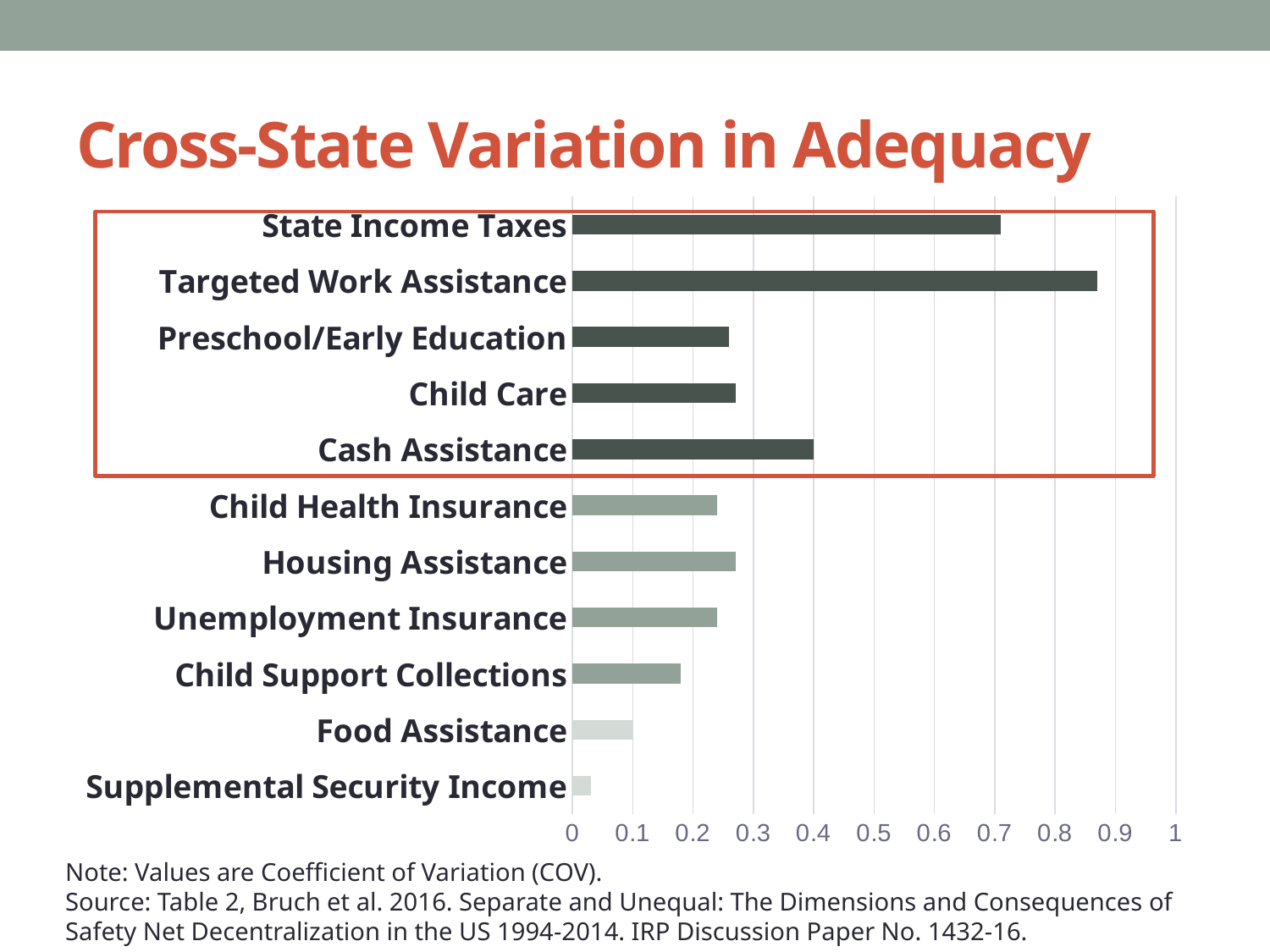
Is the value for Targeted Work Assistance greater or less than 0.8? greater Which category has the highest value in the chart? Targeted Work Assistance Is the value for State Income Taxes greater or less than 0.6? greater Which is larger, the value for Cash Assistance or the value for Food Assistance? Cash Assistance How many categories are plotted in the chart? 11 According to the note below the chart, what do the plotted values represent? Coefficient of Variation (COV) Is the value for Food Assistance greater or less than 0.2? less What kind of chart is shown on the slide? bar chart What is the title of the slide containing the chart? Cross-State Variation in Adequacy Which is larger, the value for State Income Taxes or the value for Cash Assistance? State Income Taxes Which category has the lowest value in the chart? Supplemental Security Income